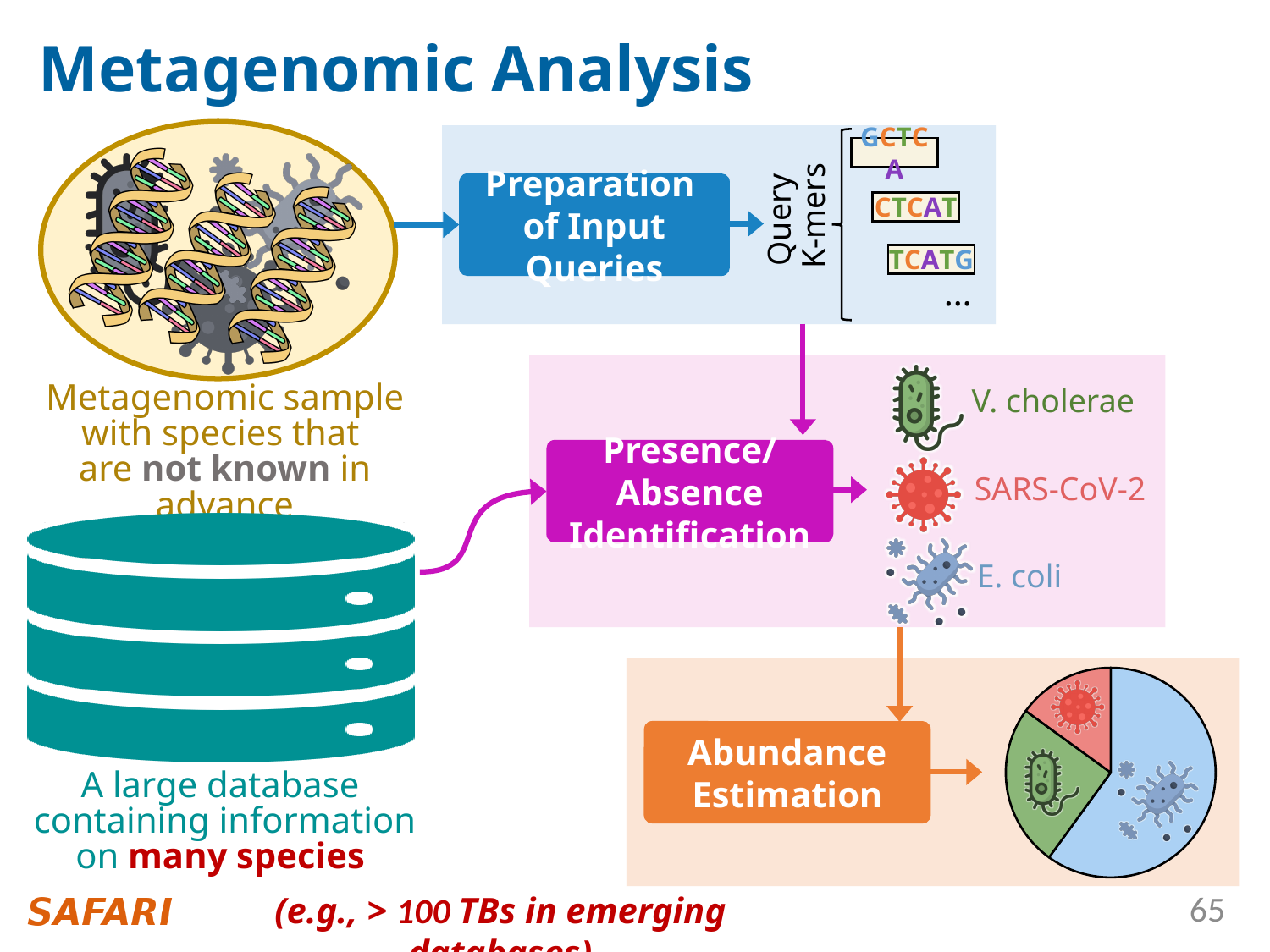
How many slices does the pie chart in the Abundance Estimation box have? 3 In the pie chart in the Abundance Estimation box, which colour slice is the largest? blue What kind of chart is shown in the Abundance Estimation box at the bottom right of the slide? pie chart In the pie chart in the Abundance Estimation box, which species icon appears in the largest slice? E. coli In the pie chart in the Abundance Estimation box, which colour slice is the smallest? red In the pie chart in the Abundance Estimation box, which is larger: the blue slice or the green slice? blue In the pie chart in the Abundance Estimation box, which species icon appears in the red slice? SARS-CoV-2